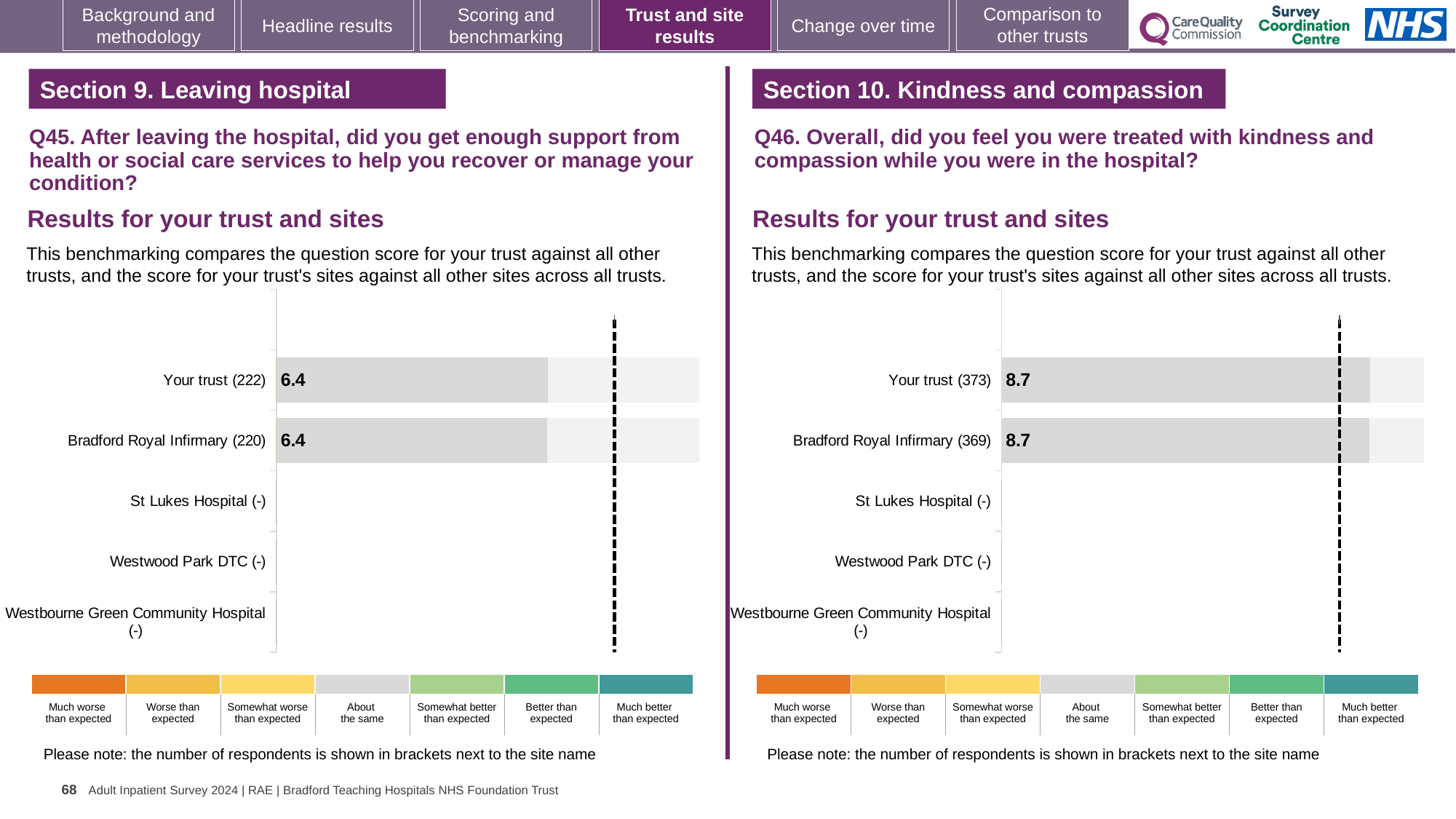
In the Q45 chart on the left, how many respondents are shown in brackets for Your trust? 222 In the Q45 chart on the left, how many sites show no score (marked with a dash)? 3 In the colour key below the Q45 chart on the left, what colour represents 'Much worse than expected'? Orange What kind of chart is used for the Q46 results on the right? Bar chart How many benchmark bands are shown in the colour key below the Q46 chart on the right? 7 In the Q46 chart on the right, what is the score for Your trust? 8.7 Which chart shows a higher score for Your trust, the Q45 chart on the left or the Q46 chart on the right? The Q46 chart on the right In the Q45 chart on the left, what is the score for Bradford Royal Infirmary? 6.4 In the Q46 chart on the right, how many respondents are shown in brackets for Bradford Royal Infirmary? 369 In the Q45 chart on the left, what is the score for Your trust? 6.4 In the Q46 chart on the right, what is the score for Bradford Royal Infirmary? 8.7 How many site/trust categories are listed on the y axis of the Q45 chart on the left? 5